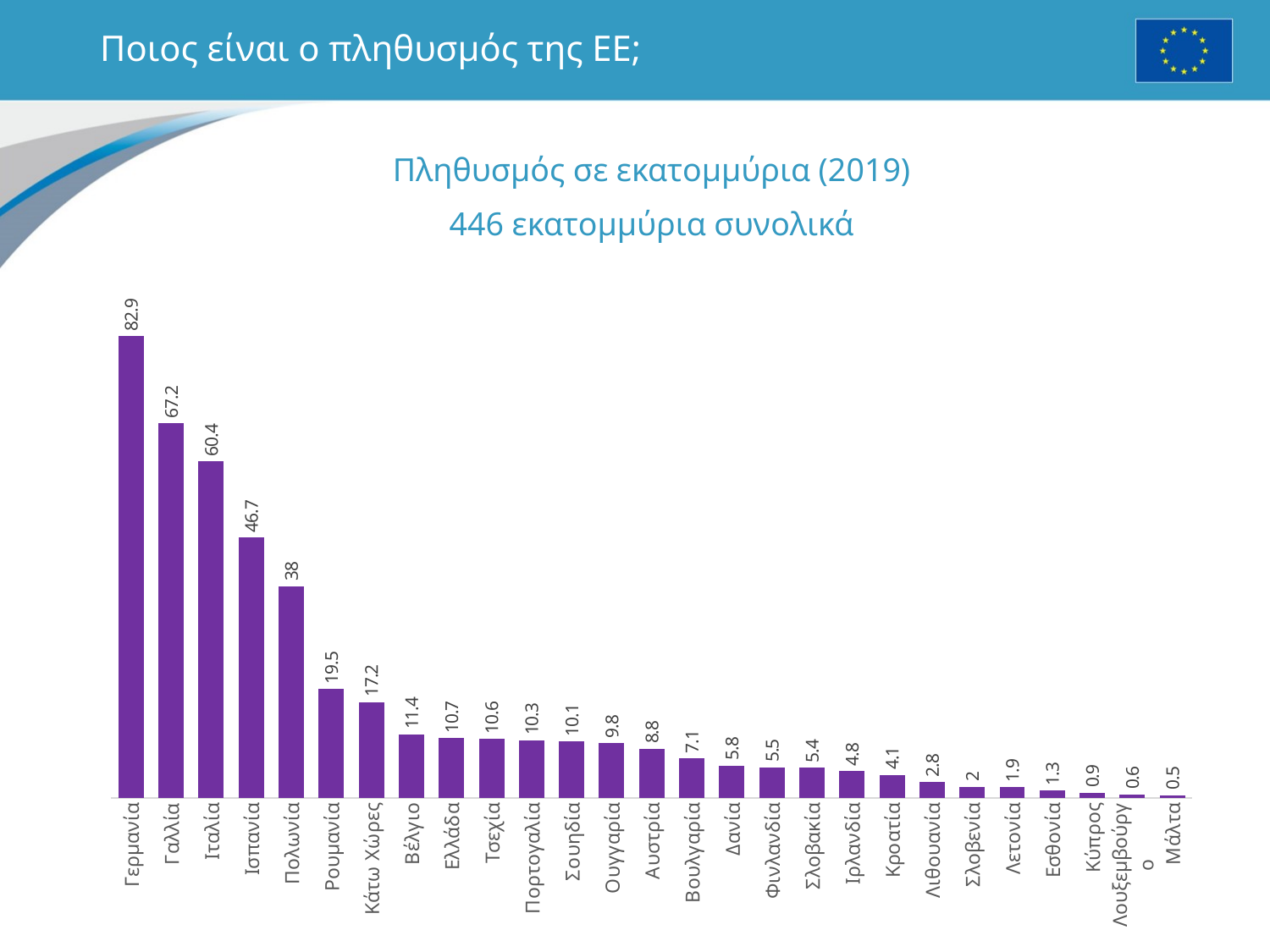
What is the difference between the values for Ισπανία and Πολωνία? 8.7 What is the population value shown for Ελλάδα? 10.7 What is the difference between the values for Γαλλία and Ιταλία? 6.8 What is the population value shown for Γερμανία? 82.9 What kind of chart is shown on the slide? Bar chart What is the population value shown for Κάτω Χώρες? 17.2 What is the title of the chart? Πληθυσμός σε εκατομμύρια (2019) How many countries are shown in the chart? 27 Which has a larger value, Ρουμανία or Βέλγιο? Ρουμανία Which country has the highest population in the chart? Γερμανία Do the values rise or fall from left to right along the x axis? Fall Which country has the lowest population in the chart? Μάλτα